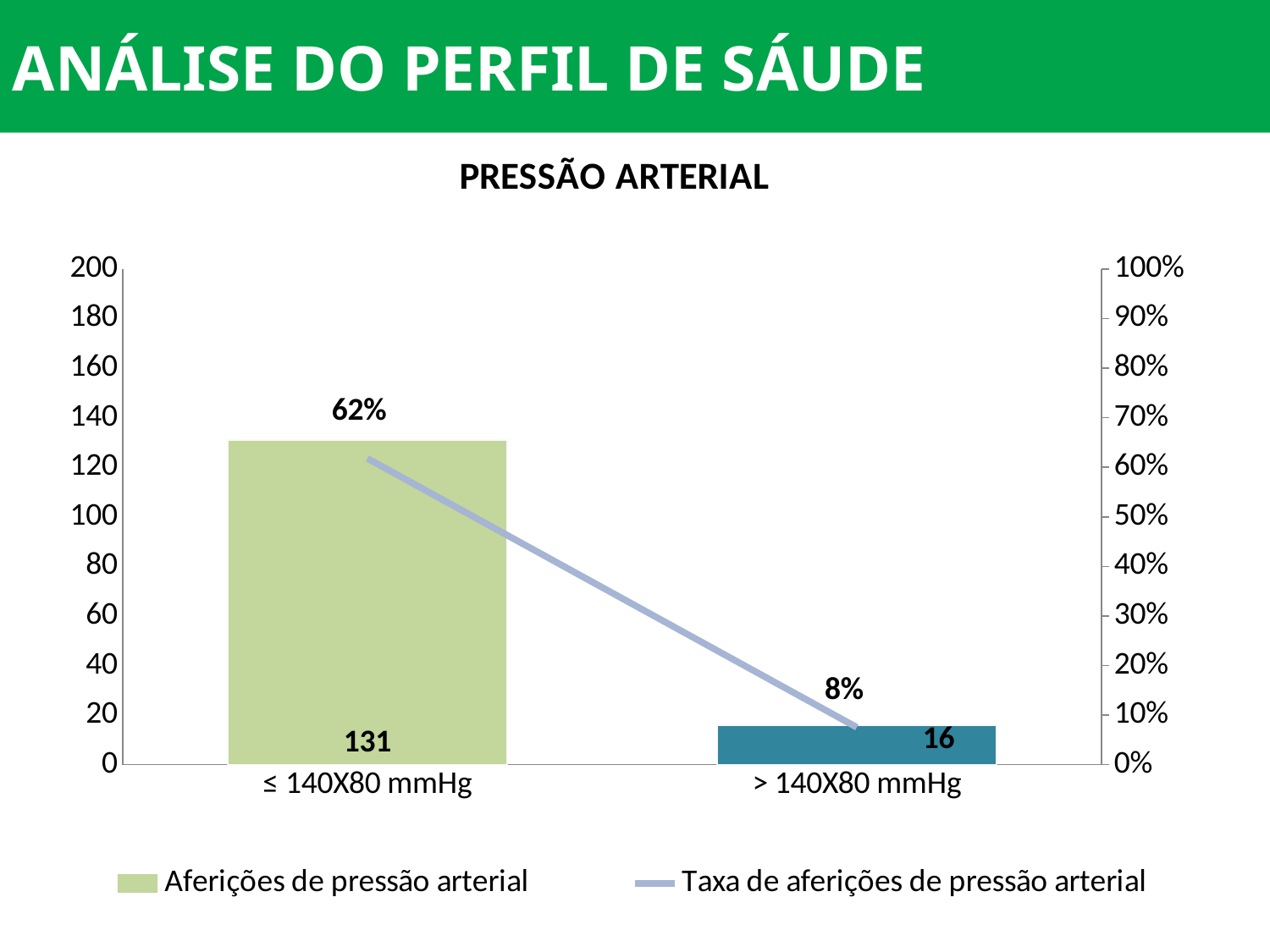
What is the value of Aferições de pressão arterial for the category ≤ 140X80 mmHg? 131 What is the Taxa de aferições de pressão arterial for the category ≤ 140X80 mmHg? 62% Which category has the highest number of Aferições de pressão arterial? ≤ 140X80 mmHg What is the title of the chart? PRESSÃO ARTERIAL Which category has more Aferições de pressão arterial, ≤ 140X80 mmHg or > 140X80 mmHg? ≤ 140X80 mmHg Which category has the lowest Taxa de aferições de pressão arterial? > 140X80 mmHg What is the value of Aferições de pressão arterial for the category > 140X80 mmHg? 16 What is the difference in Aferições de pressão arterial between ≤ 140X80 mmHg and > 140X80 mmHg? 115 What is the difference in Taxa de aferições de pressão arterial between ≤ 140X80 mmHg and > 140X80 mmHg? 54% How many categories are shown on the x axis of the chart? 2 How many series does the legend list? 2 What is the Taxa de aferições de pressão arterial for the category > 140X80 mmHg? 8%